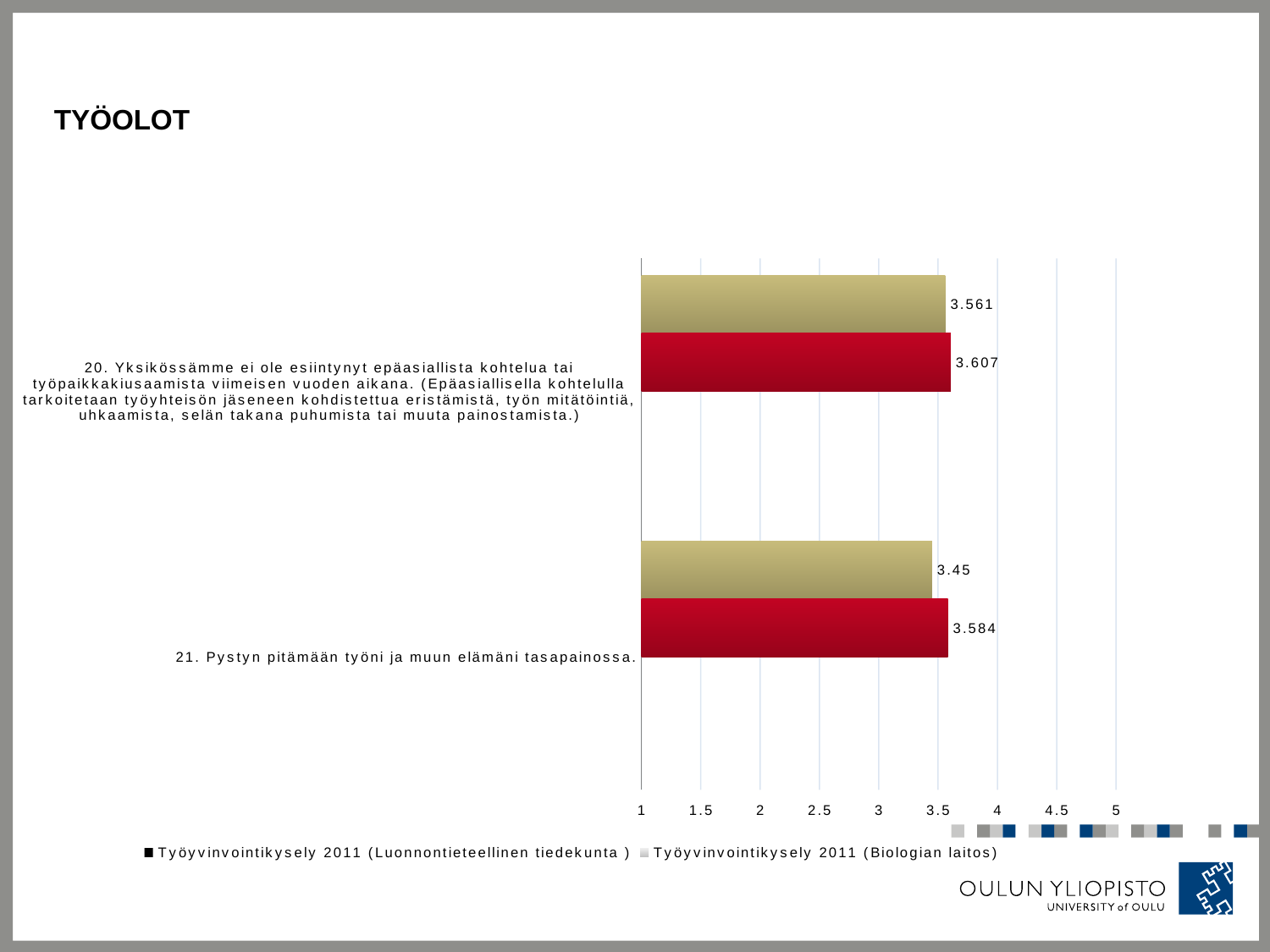
How many series does the legend list? 2 Which of the four plotted values is the lowest? 3.45 (Biologian laitos, statement 21) How many categories (survey statements) are plotted in the chart? 2 What kind of chart is shown on the slide? bar chart What is the value for Työyvinvointikysely 2011 (Luonnontieteellinen tiedekunta) for statement 20 (Yksikössämme ei ole esiintynyt epäasiallista kohtelua...)? 3.607 What is the value for Työyvinvointikysely 2011 (Biologian laitos) for statement 20 (Yksikössämme ei ole esiintynyt epäasiallista kohtelua...)? 3.561 What is the difference between the Luonnontieteellinen tiedekunta and Biologian laitos values for statement 21? 0.134 Which of the four plotted values is the highest? 3.607 (Luonnontieteellinen tiedekunta, statement 20) What is the value for Työyvinvointikysely 2011 (Luonnontieteellinen tiedekunta) for statement 21 (Pystyn pitämään työni ja muun elämäni tasapainossa)? 3.584 For statement 20, which series has the larger value: Luonnontieteellinen tiedekunta or Biologian laitos? Luonnontieteellinen tiedekunta What is the title of the slide? TYÖOLOT What is the value for Työyvinvointikysely 2011 (Biologian laitos) for statement 21 (Pystyn pitämään työni ja muun elämäni tasapainossa)? 3.45